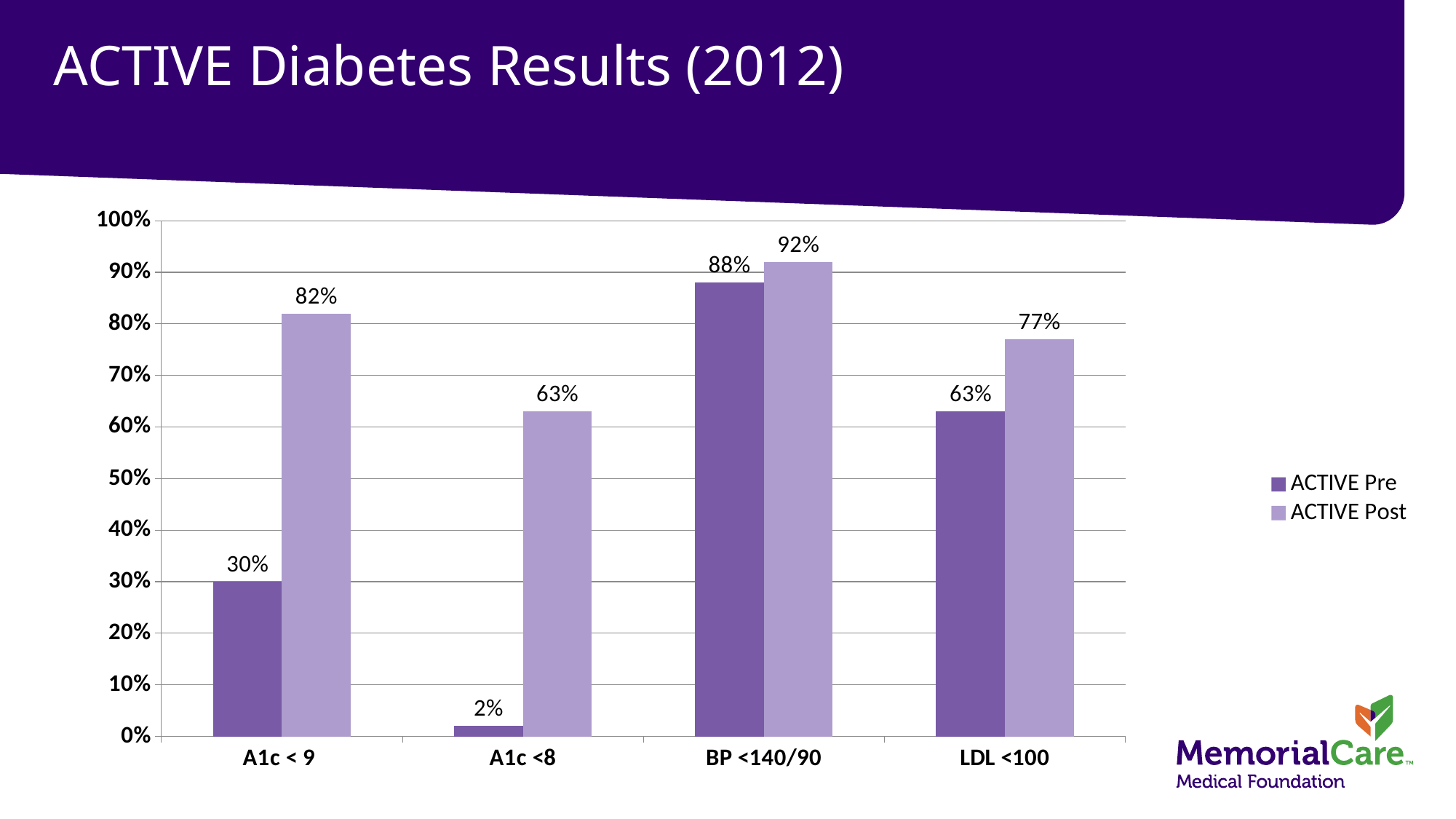
How many series does the legend list? 2 What is the ACTIVE Post value for A1c < 9? 82% What is the ACTIVE Pre value for BP <140/90? 88% What kind of chart is shown on the slide? Bar chart What is the ACTIVE Post value for LDL <100? 77% What is the difference between the ACTIVE Post and ACTIVE Pre values for A1c < 9? 52% Which is larger: the ACTIVE Pre value for LDL <100 or the ACTIVE Pre value for A1c < 9? ACTIVE Pre value for LDL <100 What is the difference between the ACTIVE Post and ACTIVE Pre values for LDL <100? 14% How many categories are shown on the x axis? 4 Which category has the lowest ACTIVE Pre value? A1c <8 Which category has the highest ACTIVE Post value? BP <140/90 What is the ACTIVE Pre value for A1c <8? 2%